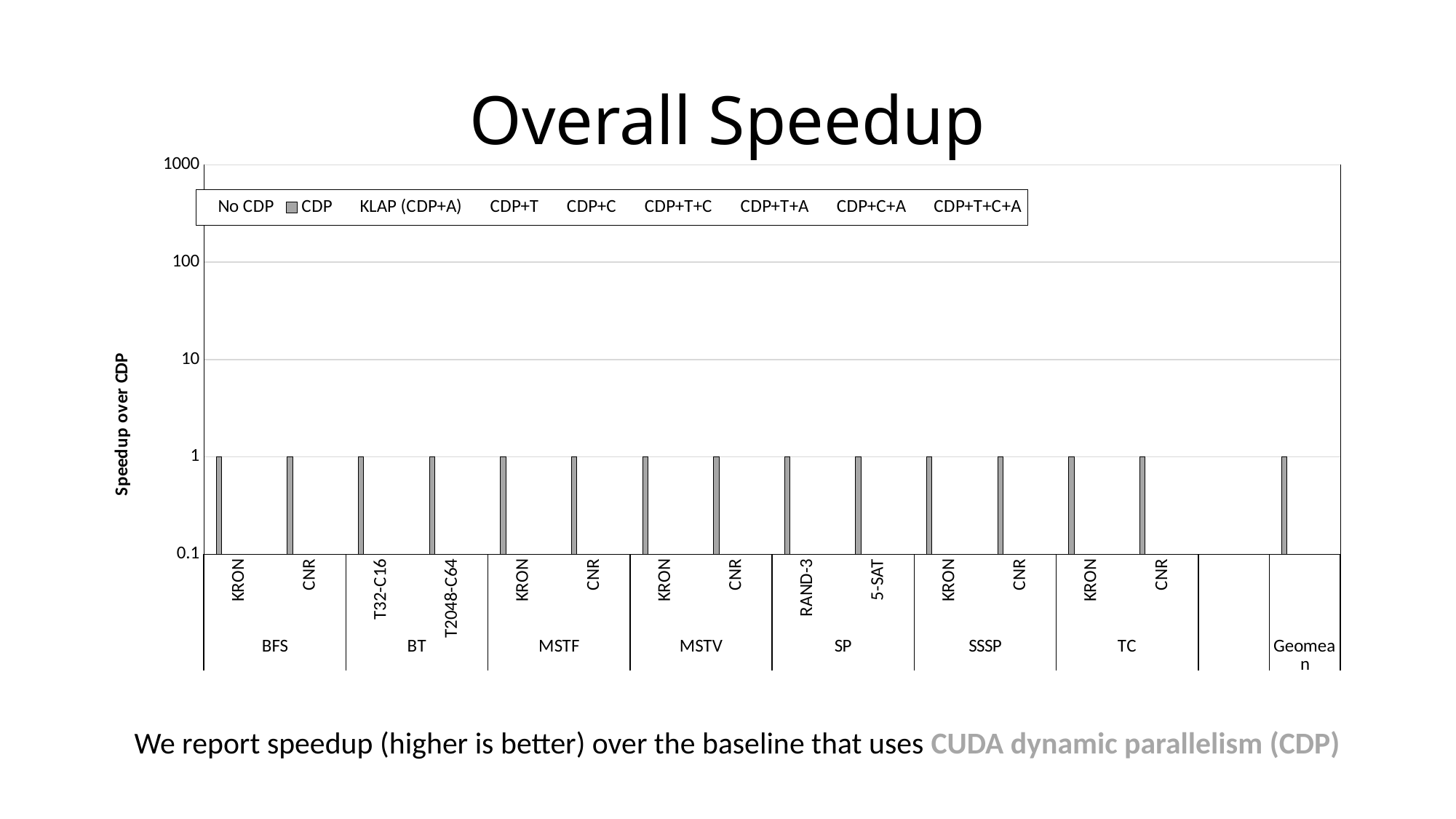
How many series does the legend list? 9 Is the CDP value for RAND-3 under SP greater or less than 10? less What is the highest value shown on the y axis? 1000 What is the CDP speedup value for Geomean? 1 What is the title of the chart? Overall Speedup How many CDP bars are plotted on the chart? 15 What is the CDP speedup value for KRON under BFS? 1 How many benchmark groups (excluding Geomean) are shown along the x axis? 7 Is the CDP value for CNR under TC greater or less than 0.1? greater What is the label of the y axis? Speedup over CDP What kind of chart is shown on the slide? bar chart What is the CDP speedup value for T32-C16 under BT? 1